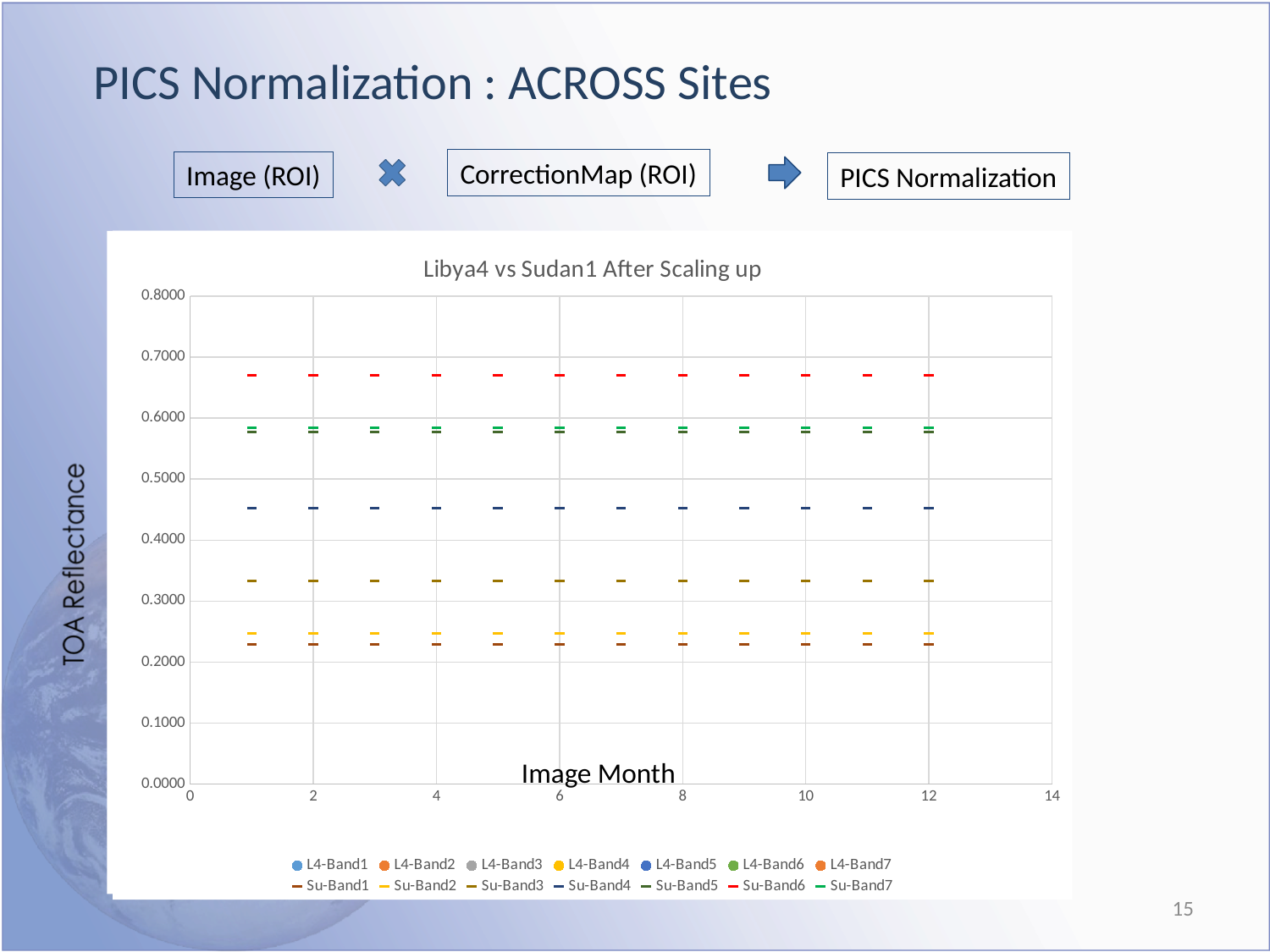
How many image months have data points plotted? 12 Is the value for Su-Band6 greater or less than 0.6000? greater Is the value for Su-Band3 greater or less than 0.3000? greater Is the value for Su-Band1 greater or less than 0.3000? less What is the title of the chart? Libya4 vs Sudan1 After Scaling up What is the label of the x axis? Image Month Do the values for Su-Band6 rise, fall, or stay flat across the image months? stay flat What kind of chart is shown on the slide? scatter chart How many series does the chart legend list? 14 Which Su-Band series has the highest TOA Reflectance values? Su-Band6